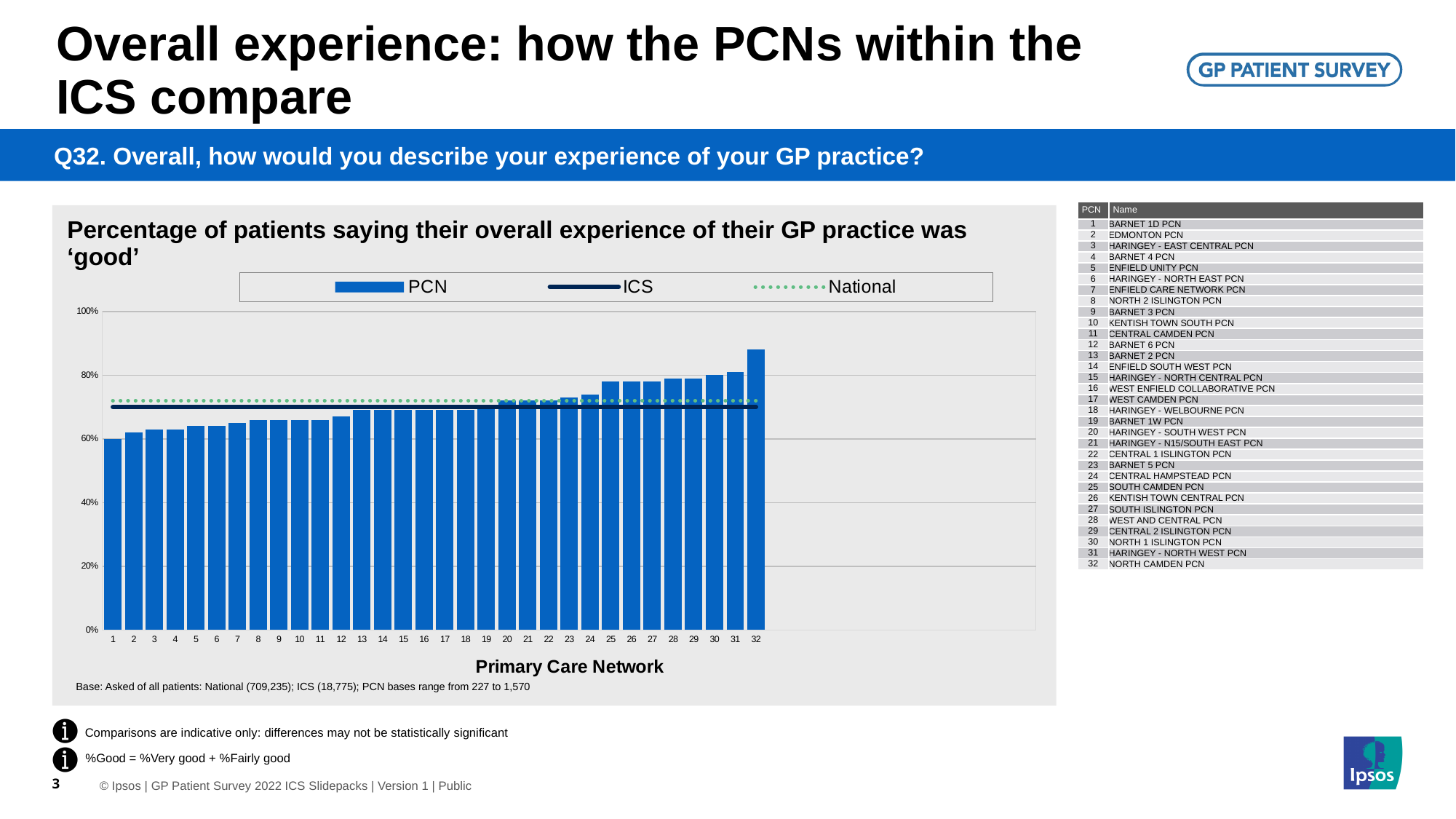
Is the value for PCN 32 greater or less than 80%? greater Which PCN number has the highest percentage of patients saying their overall experience was 'good'? 32 Is the value for PCN 1 greater or less than 80%? less Do the bar values rise or fall as you move from PCN 1 to PCN 32 along the x axis? rise Is the value for PCN 10 greater or less than 40%? greater What are the three entries listed in the chart legend? PCN, ICS, National What kind of chart is shown on the slide? bar chart Which has the larger value, PCN 32 or PCN 1? PCN 32 How many series does the chart legend list? 3 What is the label on the x axis of the chart? Primary Care Network Which PCN number has the lowest percentage of patients saying their overall experience was 'good'? 1 How many Primary Care Networks (PCNs) are plotted as bars on the chart? 32